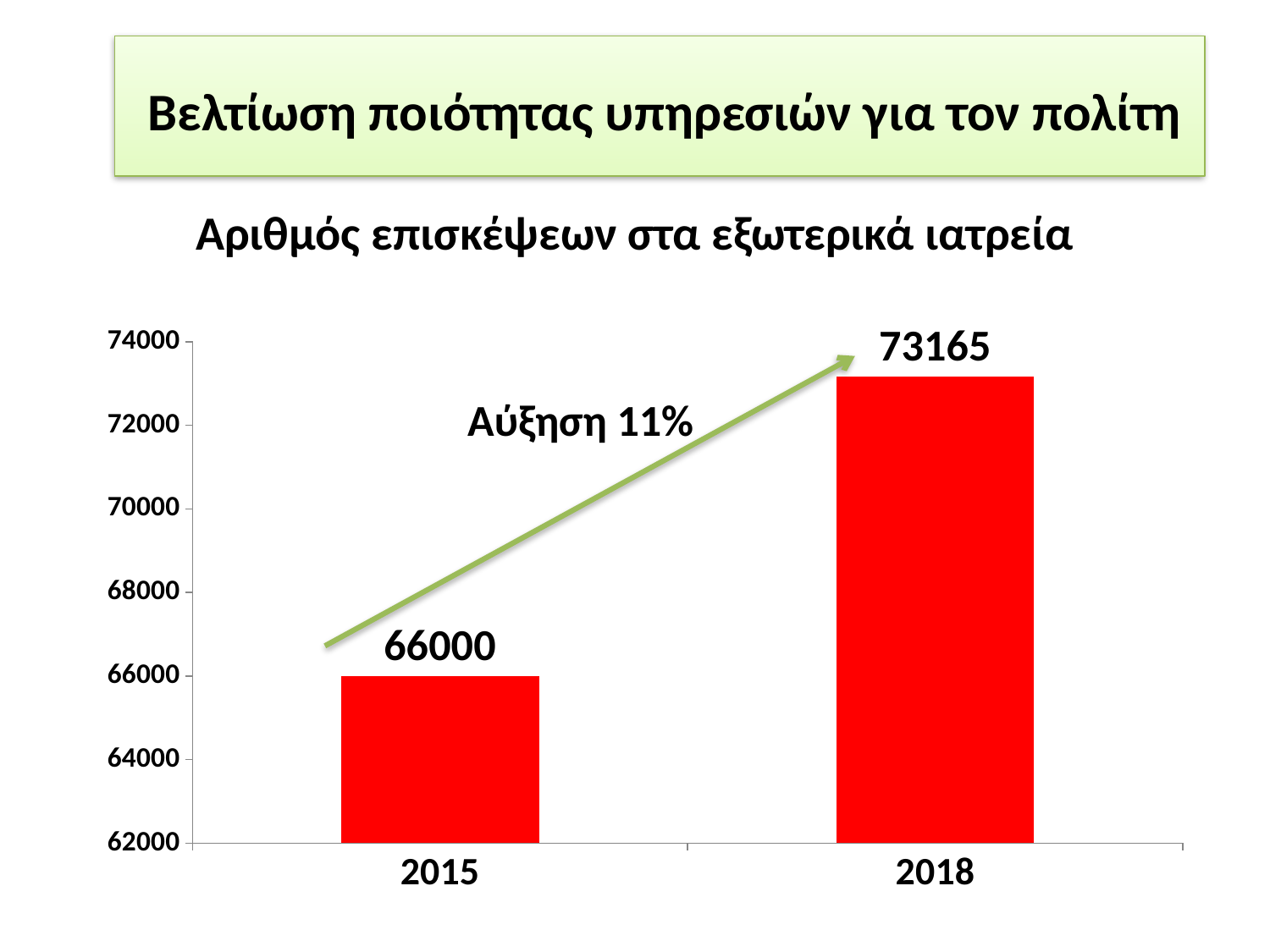
Do the values rise or fall from 2015 to 2018? rise What kind of chart is shown? bar chart Is the value for 2015 greater or less than 68000? less What percentage increase is annotated on the chart? 11% Which year has the higher number of visits? 2018 What colour are the bars? red What is the number of visits for 2015? 66000 Which year has the lower number of visits? 2015 What is the number of visits for 2018? 73165 How many years are shown on the x axis? 2 What is the difference between the 2018 and 2015 values? 7165 Is the value for 2018 greater or less than 72000? greater